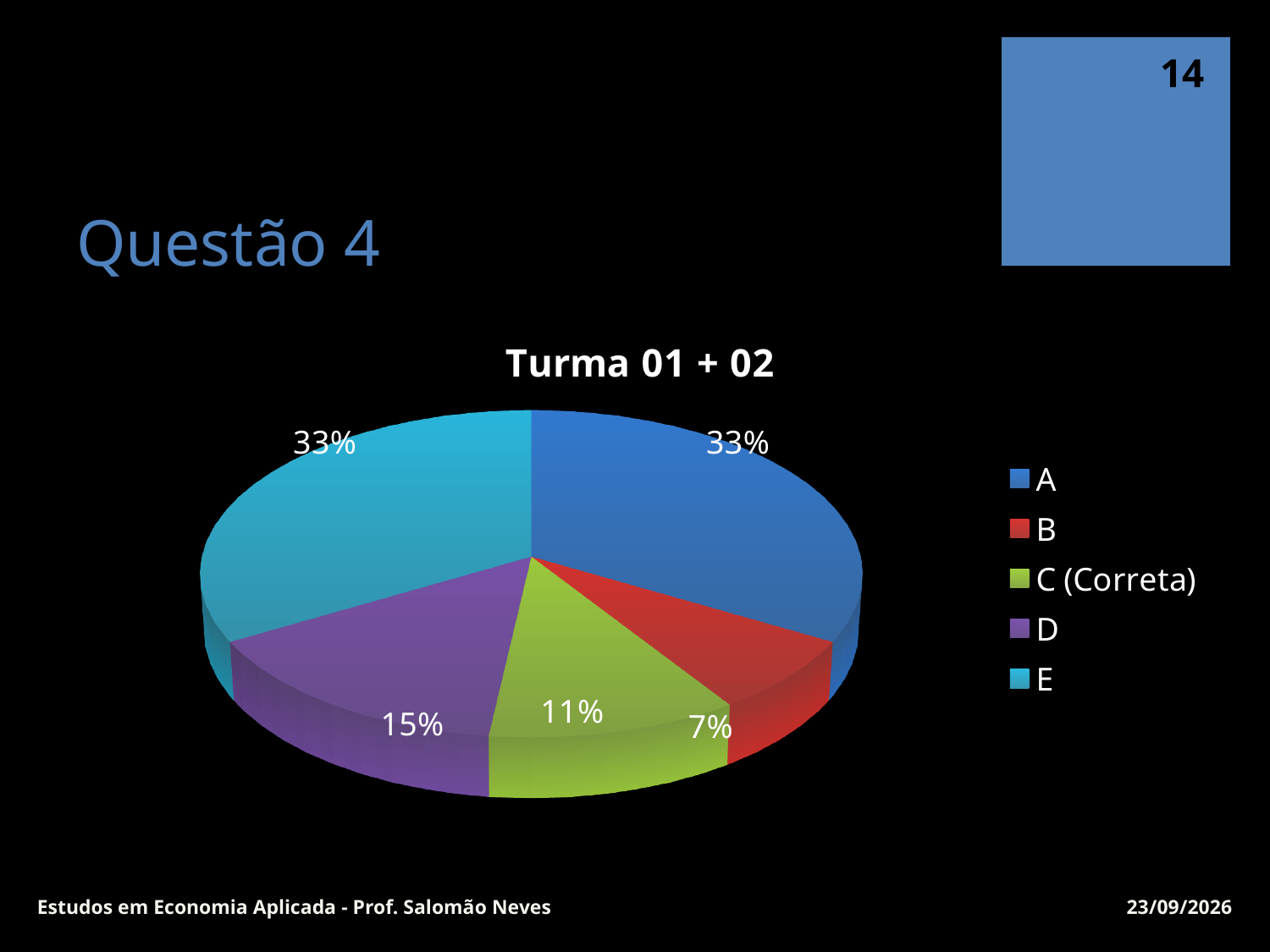
What is the difference in percentage points between slice D and slice B? 8% Which legend entry is marked as the correct answer? C (Correta) What share of the pie does slice A represent? 33% What share of the pie does slice E represent? 33% What share of the pie does slice B represent? 7% How many slices does the pie chart have? 5 Which slice has the smallest share of the pie? B What is the title of the chart? Turma 01 + 02 What kind of chart is shown on the slide? pie chart Which slice is larger, D or C (Correta)? D